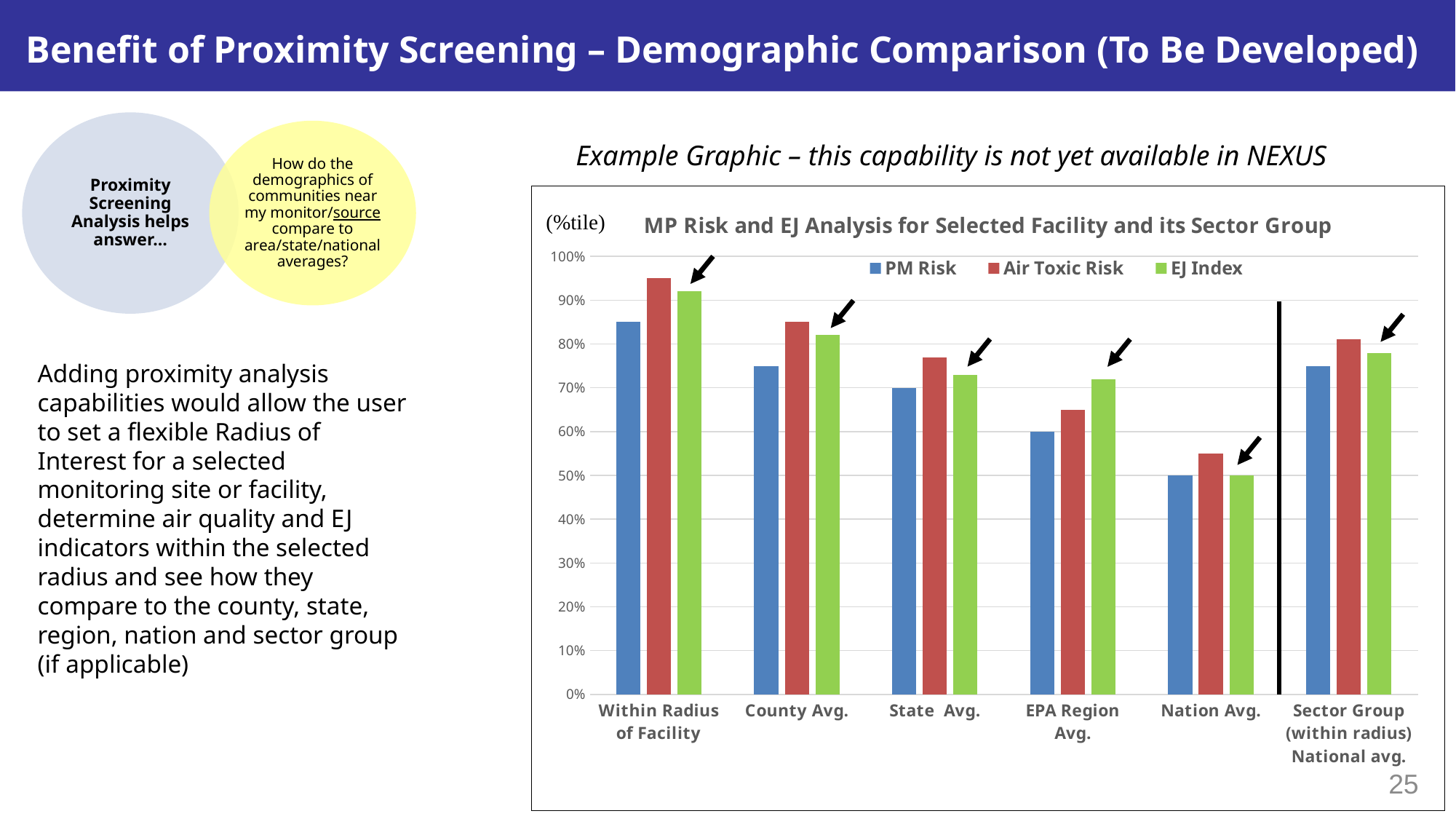
Is the Air Toxic Risk value for EPA Region Avg. greater or less than 70%? less Which category has the lowest EJ Index value? Nation Avg. Which category has the highest Air Toxic Risk value? Within Radius of Facility Is the PM Risk value for Sector Group (within radius) National avg. greater or less than 70%? greater What kind of chart is shown on the slide? Bar chart Is the EJ Index value for County Avg. greater or less than 80%? greater How many series does the chart legend list? 3 How many categories are shown along the x axis of the chart? 6 For Within Radius of Facility, which is larger: PM Risk or Air Toxic Risk? Air Toxic Risk What is the title of the chart? MP Risk and EJ Analysis for Selected Facility and its Sector Group Does the EJ Index value rise or fall from Within Radius of Facility to Nation Avg.? Fall